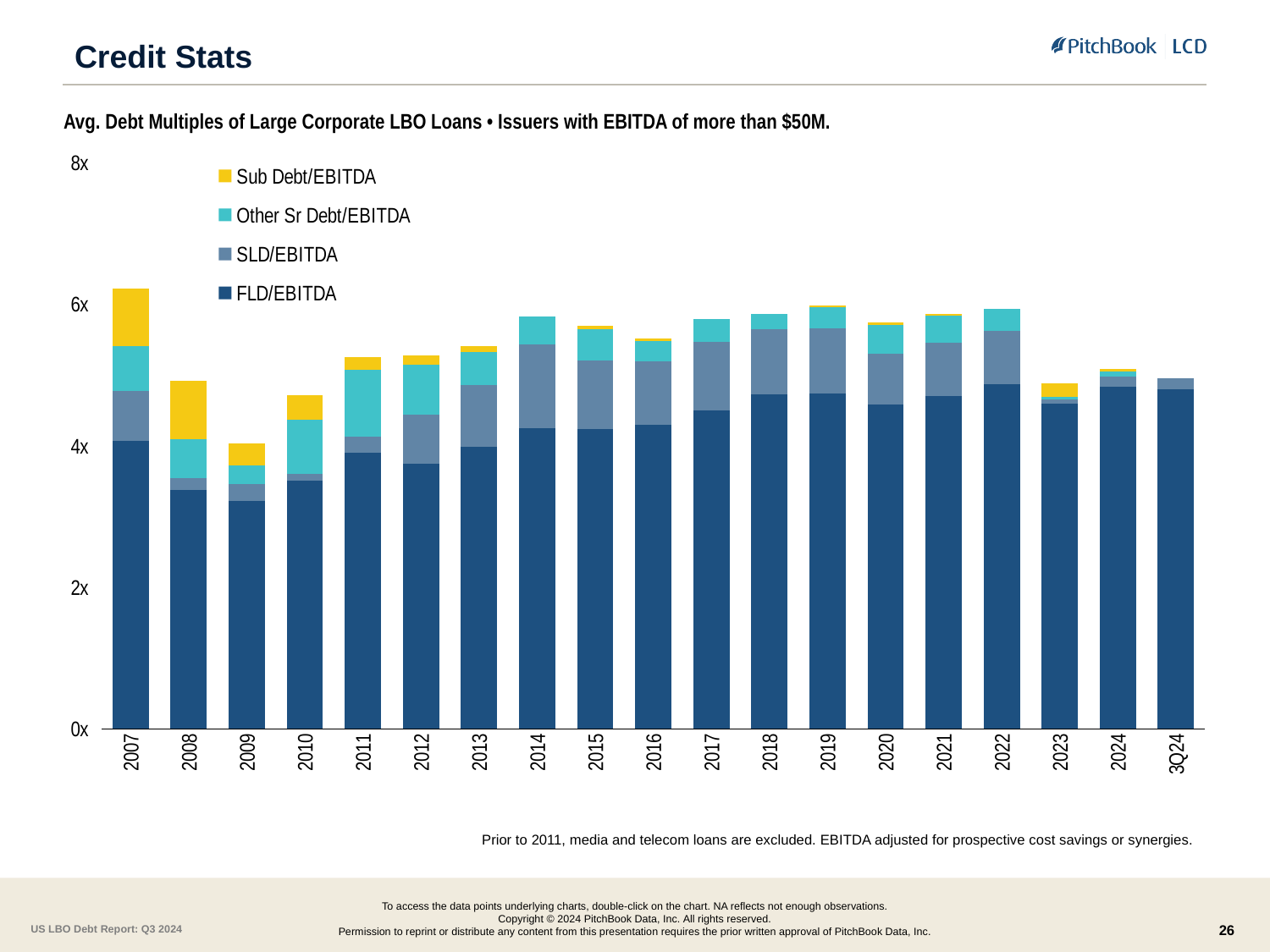
Is the FLD/EBITDA value for 2009 greater or less than 4x? less Is the FLD/EBITDA value for 2022 greater or less than 4x? greater Which has a larger total debt multiple, 2013 or 2014? 2014 What kind of chart is shown on the slide? Stacked bar chart Is the total debt multiple for 2007 greater or less than 6x? greater How many categories are shown along the x axis? 19 How many series does the legend list? 4 Which year has the lowest total debt multiple? 2009 Do the total debt multiples rise or fall from 2009 to 2014? rise Which series is shown in yellow in the legend? Sub Debt/EBITDA Which year has the highest total debt multiple? 2007